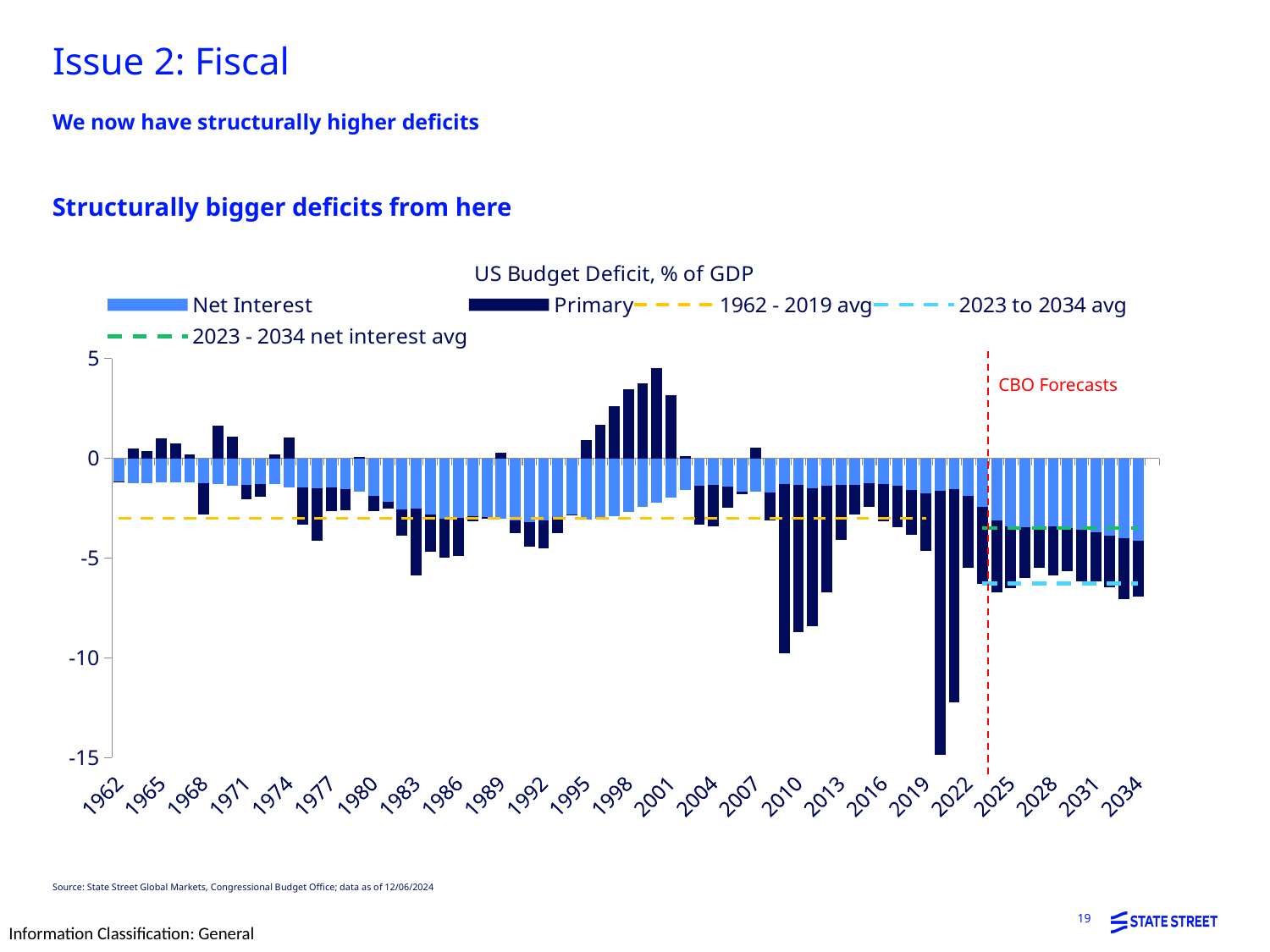
Is the Primary value for 2000 greater or less than 0? greater What does the red dashed vertical line on the chart mark? CBO Forecasts Which year has the lowest total stacked bar value? 2020 Is the total stacked bar value for 2020 greater or less than -10? less Is the 2023 to 2034 avg dashed line greater or less than -5? less What is the title of the chart? US Budget Deficit, % of GDP Which year has the larger Primary value, 1998 or 2000? 2000 What type of chart is shown on the slide? bar chart Which year has the highest Primary value? 2000 How many year labels are shown on the x axis? 25 How many entries does the chart legend list? 5